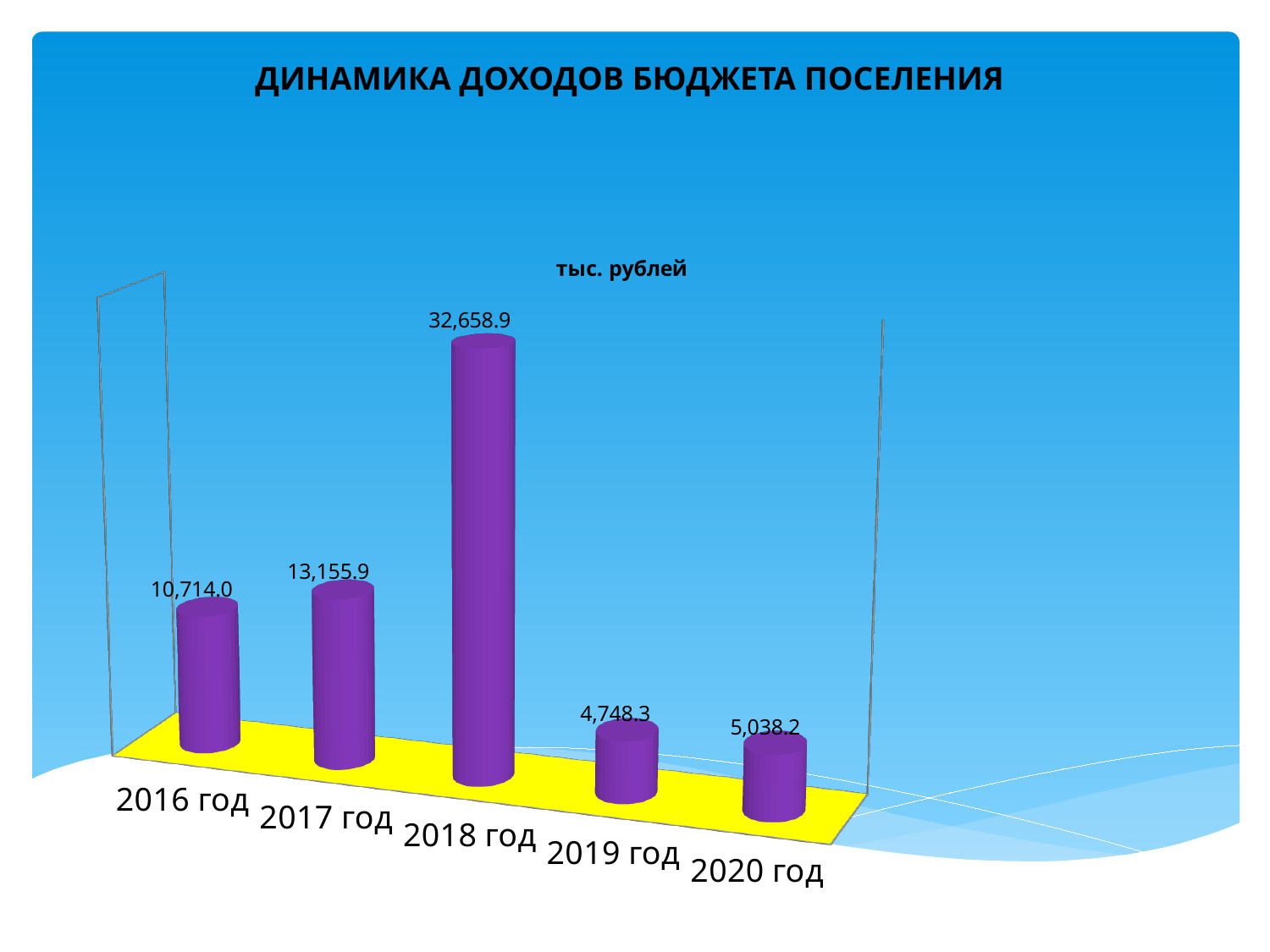
What is the value for 2020 год? 5,038.2 What is the difference between the values for 2018 год and 2017 год? 19,503.0 Do the values rise or fall from 2016 год to 2018 год? Rise Which is larger, the value for 2017 год or the value for 2016 год? 2017 год What unit of measurement is indicated on the chart? тыс. рублей What is the value for 2018 год? 32,658.9 How many years are shown on the chart? 5 What is the difference between the values for 2020 год and 2019 год? 289.9 What kind of chart is shown on the slide? Bar chart Which year has the lowest value? 2019 год What is the value for 2016 год? 10,714.0 Which year has the highest value? 2018 год